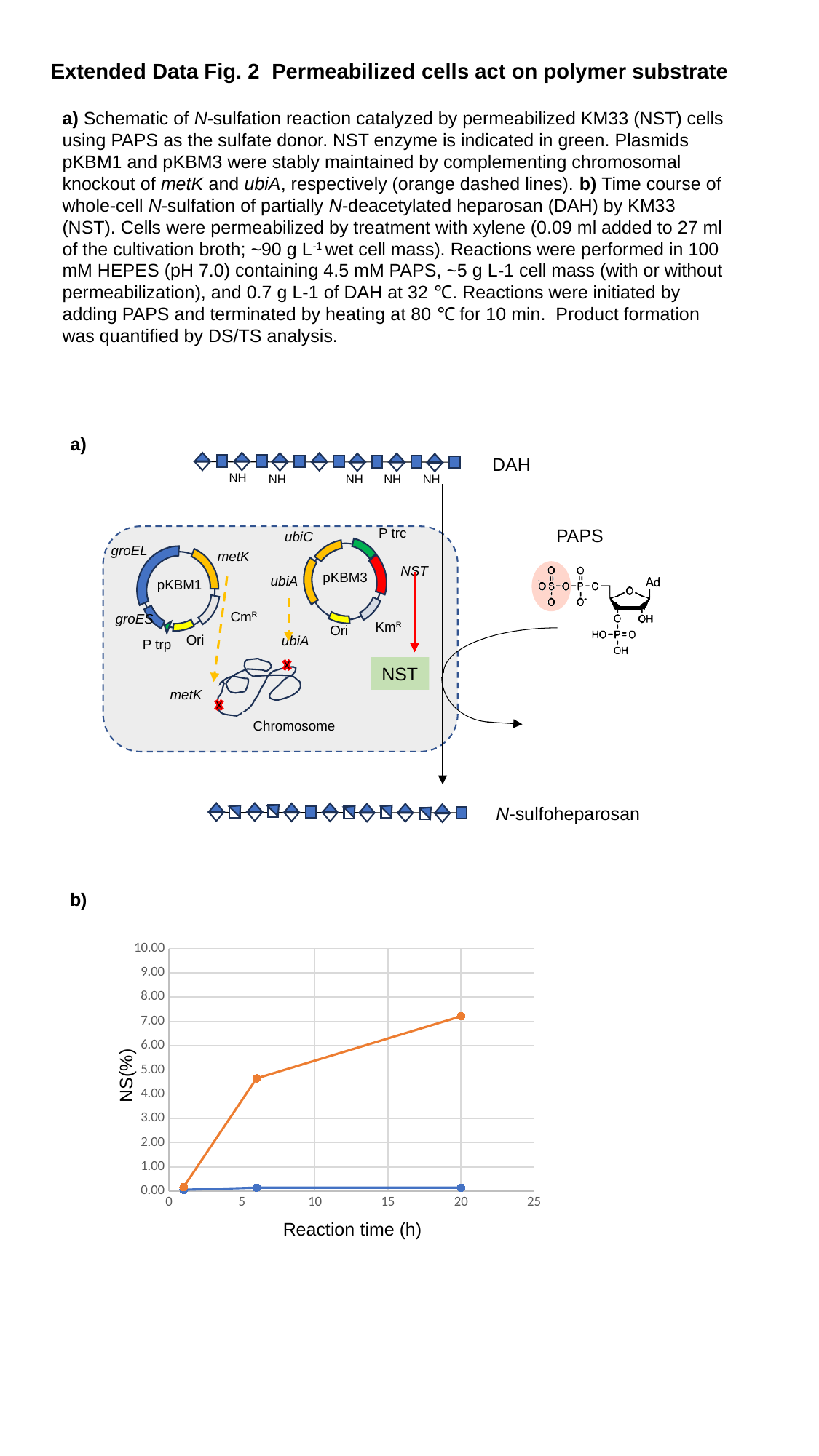
In the chart in panel b), which line has the higher value at 20 h, the orange line or the blue line? orange line In the chart in panel b), is the value of the blue line at 20 h greater or less than 1.00? less In the chart in panel b), how many data points does the orange line have? 3 In the chart in panel b), does the orange line rise or fall as reaction time increases? rise In the chart in panel b), is the value of the orange line at 20 h greater or less than 5.00? greater In the chart in panel b), how many lines are plotted? 2 In the chart in panel b), at which reaction time does the orange line reach its highest value? 20 h In the chart in panel b), what is the maximum value shown on the y axis? 10.00 What kind of chart is shown in panel b)? line chart In the chart in panel b), what is the label of the x axis? Reaction time (h) In the chart in panel b), what is the label of the y axis? NS(%) In the chart in panel b), is the value of the orange line at 20 h greater or less than 8.00? less